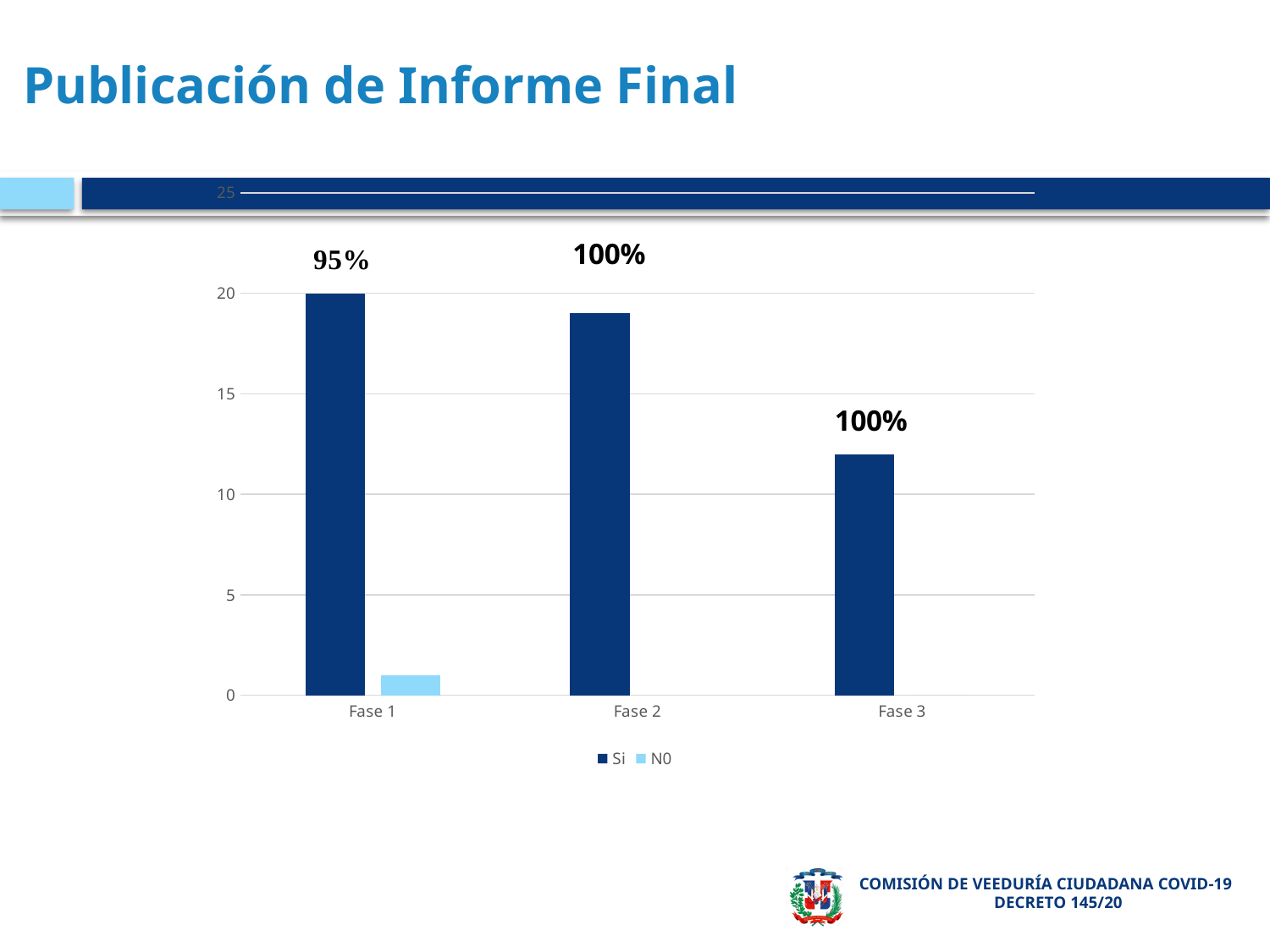
Is the Si value for Fase 3 greater or less than 15? less Which fase has the lowest Si bar? Fase 3 Do the Si values rise or fall from Fase 1 to Fase 3? Fall What are the two series named in the legend? Si and N0 How many series does the legend list? 2 What percentage label is shown above Fase 1? 95% What is the value of the Si bar for Fase 1? 20 Which fase has the highest Si bar? Fase 1 How many categories (fases) are shown on the x axis? 3 What percentage label is shown above Fase 3? 100% What is the title of the chart on the slide? Publicación de Informe Final What kind of chart is shown on the slide? Bar chart